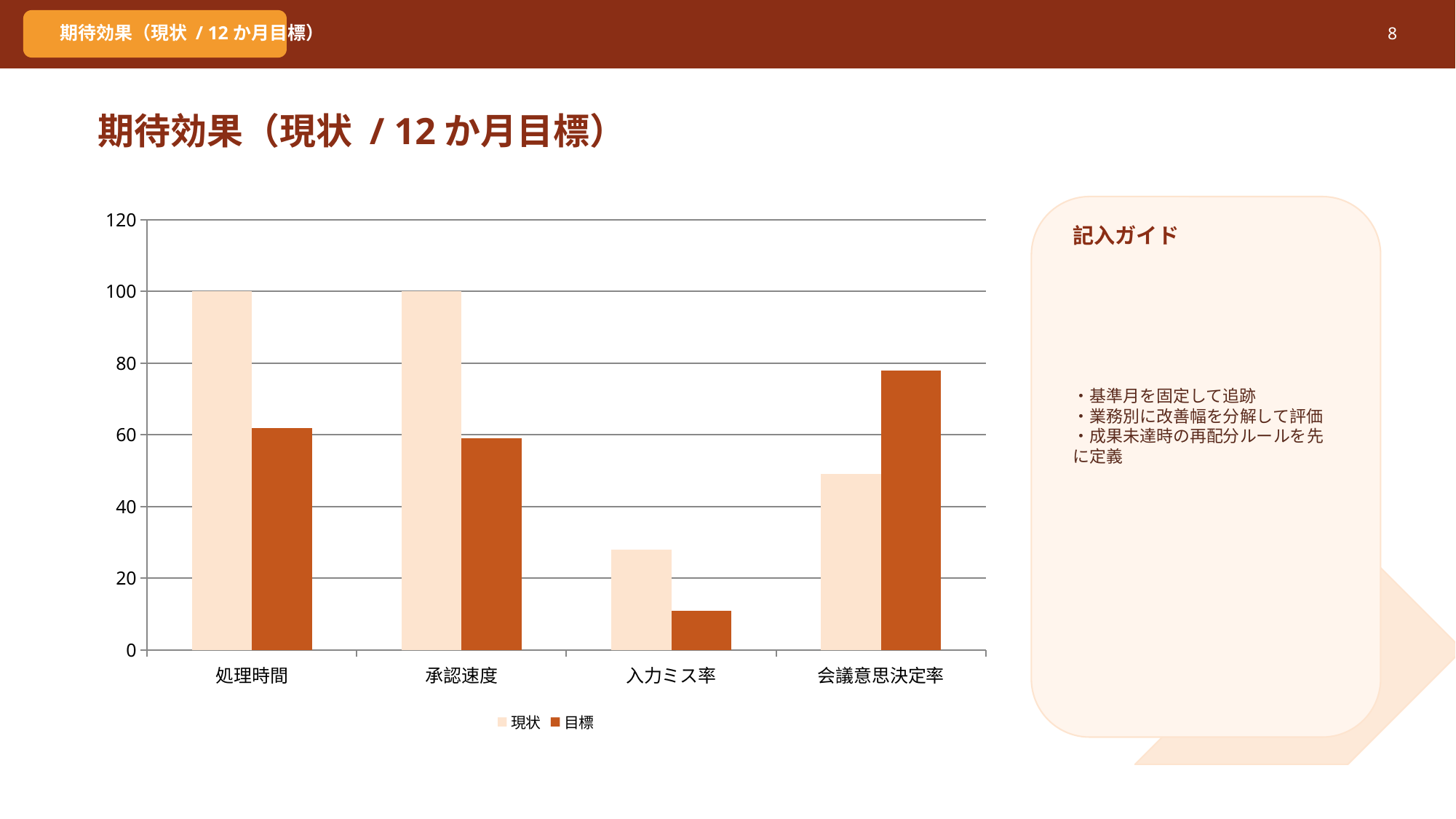
Which category has the lowest 目標 value? 入力ミス率 What is the 現状 value for 承認速度? 100 Is the 目標 value for 入力ミス率 greater or less than 20? less What are the two series named in the chart's legend? 現状 and 目標 How many series does the chart's legend list? 2 Is the 目標 value for 会議意思決定率 greater or less than 60? greater Which category has the highest 目標 value? 会議意思決定率 How many categories are shown on the x axis of the chart? 4 What is the 現状 value for 処理時間? 100 What kind of chart is shown on the slide? bar chart Is the 現状 value for 入力ミス率 greater or less than 40? less For 会議意思決定率, which is larger: the 現状 value or the 目標 value? 目標